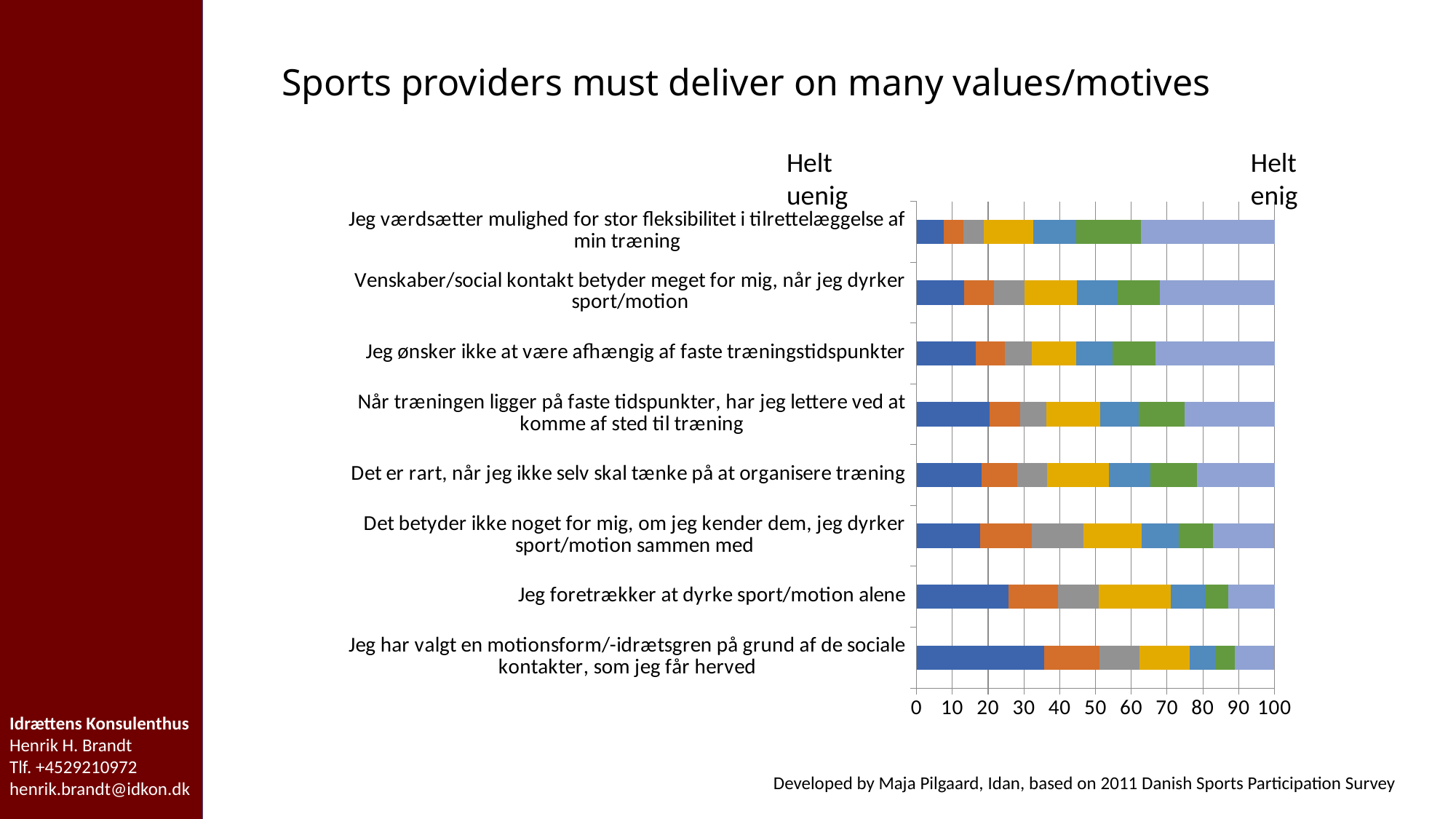
What kind of chart is shown on the slide? Stacked bar chart Which has the larger dark blue (leftmost) segment: 'Jeg foretrækker at dyrke sport/motion alene' or 'Jeg ønsker ikke at være afhængig af faste træningstidspunkter'? Jeg foretrækker at dyrke sport/motion alene How many statements (categories) are listed on the chart? 8 Is the dark blue (leftmost) segment for 'Jeg værdsætter mulighed for stor fleksibilitet i tilrettelæggelse af min træning' greater or less than 10? less What is the title of the slide? Sports providers must deliver on many values/motives Which statement has the largest light blue (rightmost) segment? Jeg værdsætter mulighed for stor fleksibilitet i tilrettelæggelse af min træning What labels appear at the left and right ends of the chart's scale? Helt uenig and Helt enig Is the dark blue (leftmost) segment for 'Jeg har valgt en motionsform/-idrætsgren på grund af de sociale kontakter, som jeg får herved' greater or less than 30? greater Which statement has the smallest dark blue (leftmost) segment? Jeg værdsætter mulighed for stor fleksibilitet i tilrettelæggelse af min træning Which statement has the largest dark blue (leftmost) segment? Jeg har valgt en motionsform/-idrætsgren på grund af de sociale kontakter, som jeg får herved What is the total of each stacked bar, as read from the axis? 100 How many coloured segments make up each stacked bar? 7